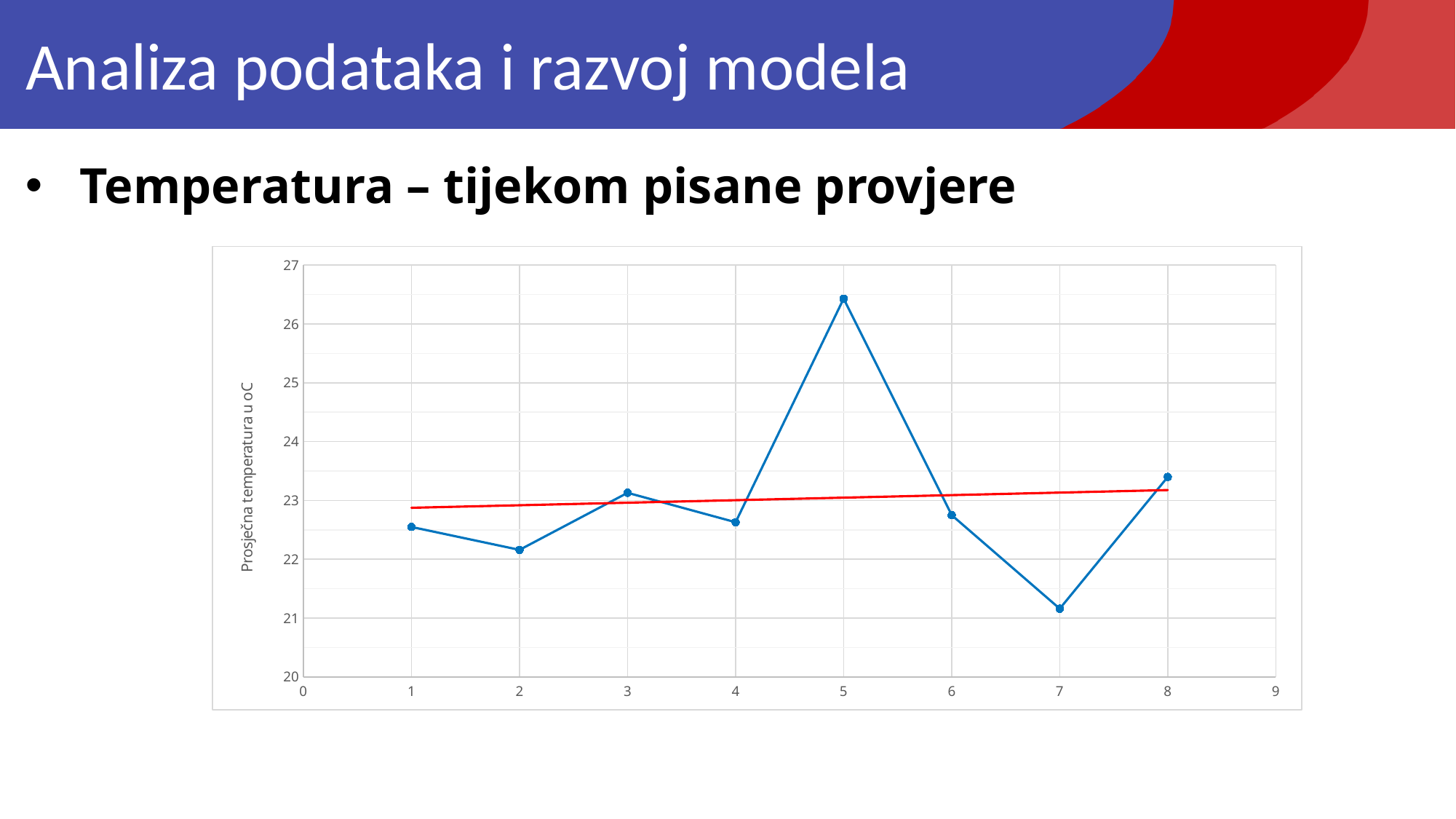
Which has the higher value, x = 5 or x = 8? 5 Which has the higher value, x = 2 or x = 7? 2 What kind of chart is shown on the slide? line chart At which x value does the blue line reach its lowest temperature? 7 Is the value at x = 8 greater or less than 23? greater Is the value at x = 2 greater or less than 23? less What is the label on the vertical axis? Prosječna temperatura u oC How many data points are plotted on the blue line? 8 At which x value does the blue line reach its highest temperature? 5 Is the value at x = 7 greater or less than 22? less Does the red trend line rise or fall from left to right? rise